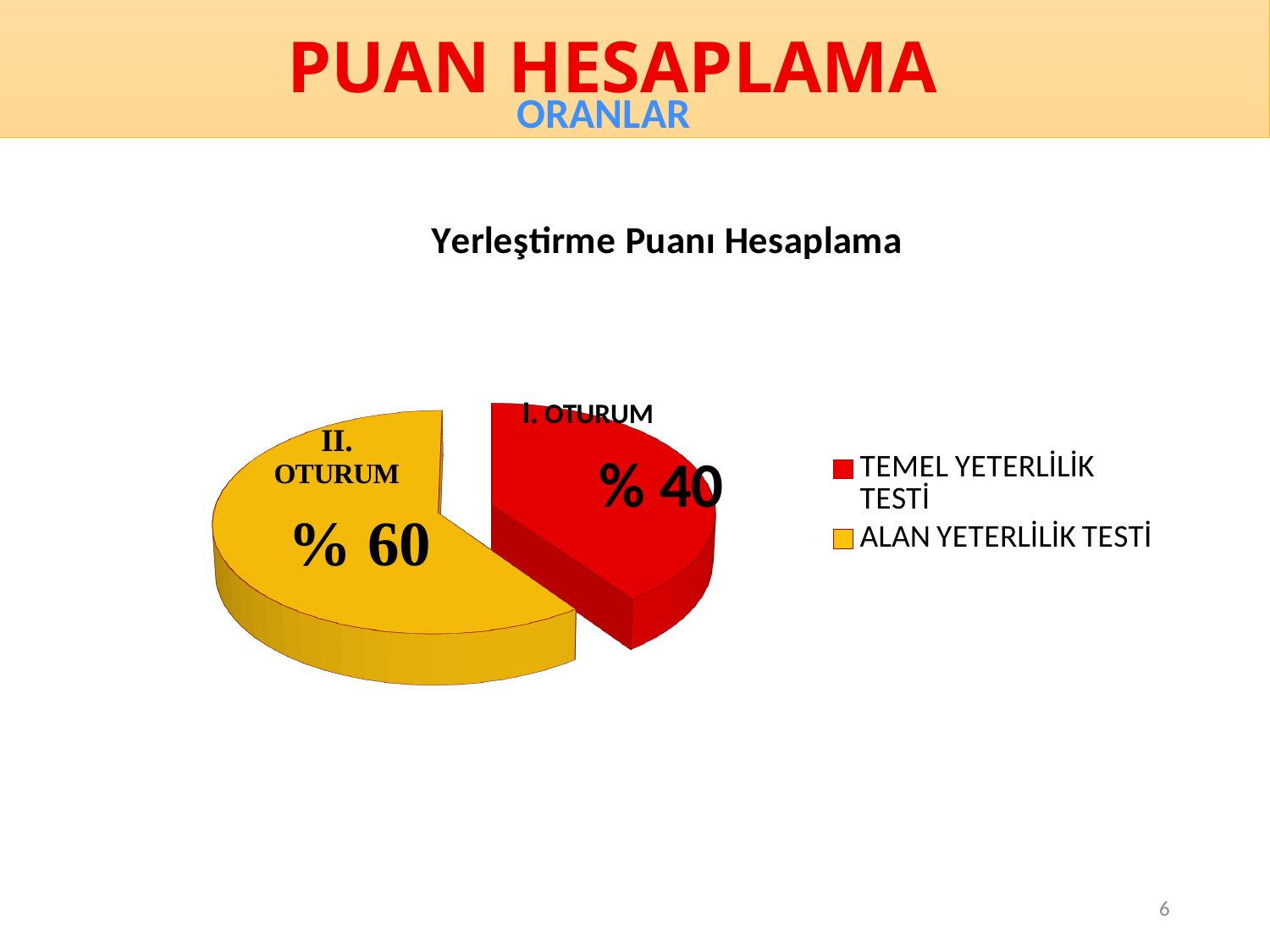
How many entries does the legend list? 2 Which legend entry corresponds to the red slice? TEMEL YETERLİLİK TESTİ What kind of chart is shown on the slide? pie chart How many slices does the pie chart have? 2 What is the difference between the II. OTURUM and I. OTURUM values? % 20 Which slice is the largest? II. OTURUM What value is shown for the II. OTURUM slice? % 60 What value is shown for the I. OTURUM slice? % 40 Which slice is the smallest? I. OTURUM What share of the pie does the ALAN YETERLİLİK TESTİ slice represent? % 60 Which is larger, the I. OTURUM slice or the II. OTURUM slice? II. OTURUM What is the chart's title? Yerleştirme Puanı Hesaplama